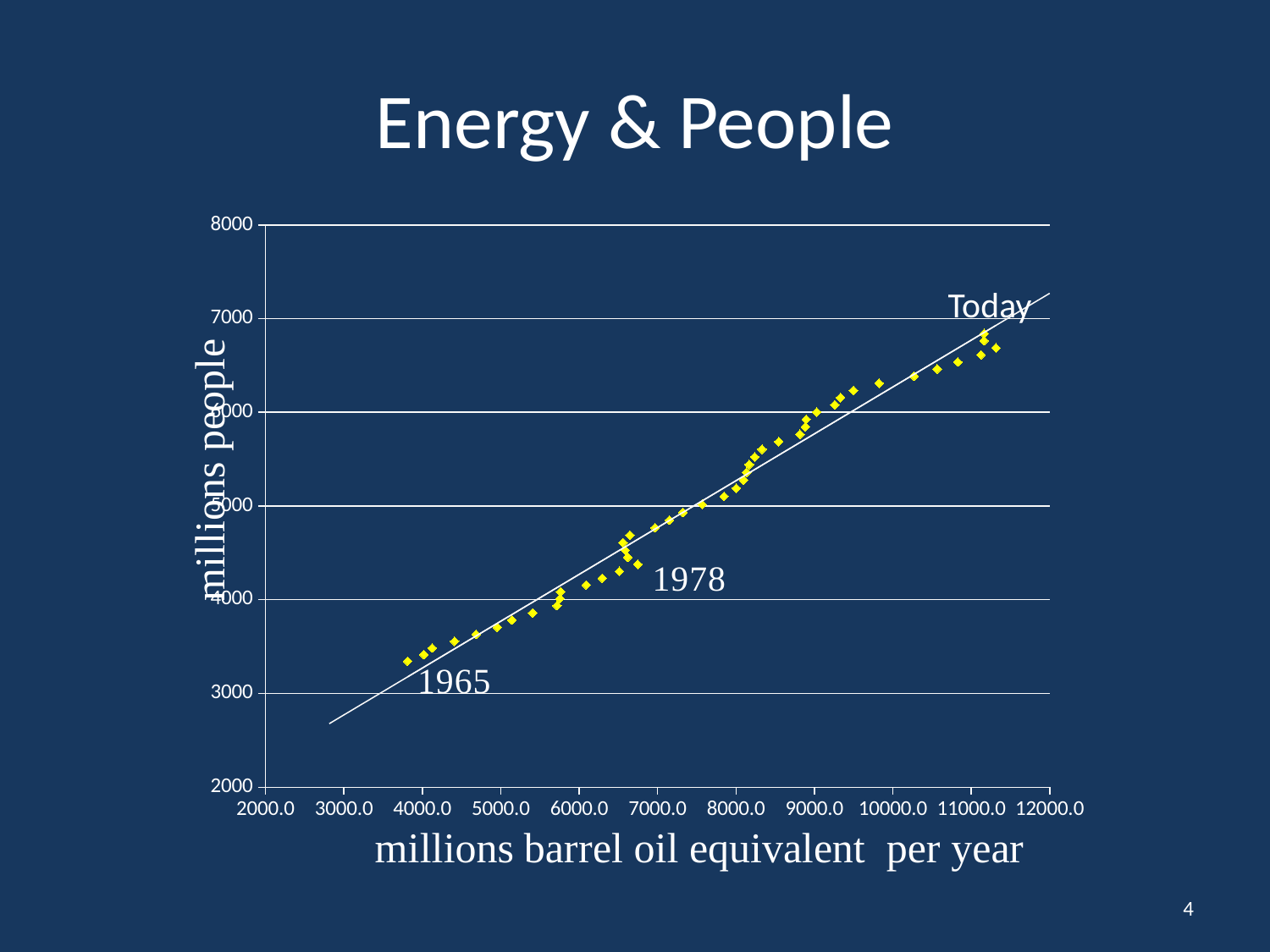
Is the energy value (x axis) for the rightmost points labelled "Today" greater or less than 11000.0? greater What is the title of the chart on the slide? Energy & People Is the millions-people value for the points near the 1978 label greater or less than 4000? greater As energy use increases along the x axis, do the plotted values for millions of people rise or fall? rise Is the millions-people value for the points labelled "Today" greater or less than 6000? greater What is the label of the x axis? millions barrel oil equivalent per year Which has the higher millions-people value: the points near 1978 or the points labelled "Today"? Today Which has the higher millions-people value: the point labelled 1965 or the points labelled "Today"? Today What kind of chart is shown on the slide? scatter chart What is the highest value shown on the y axis? 8000